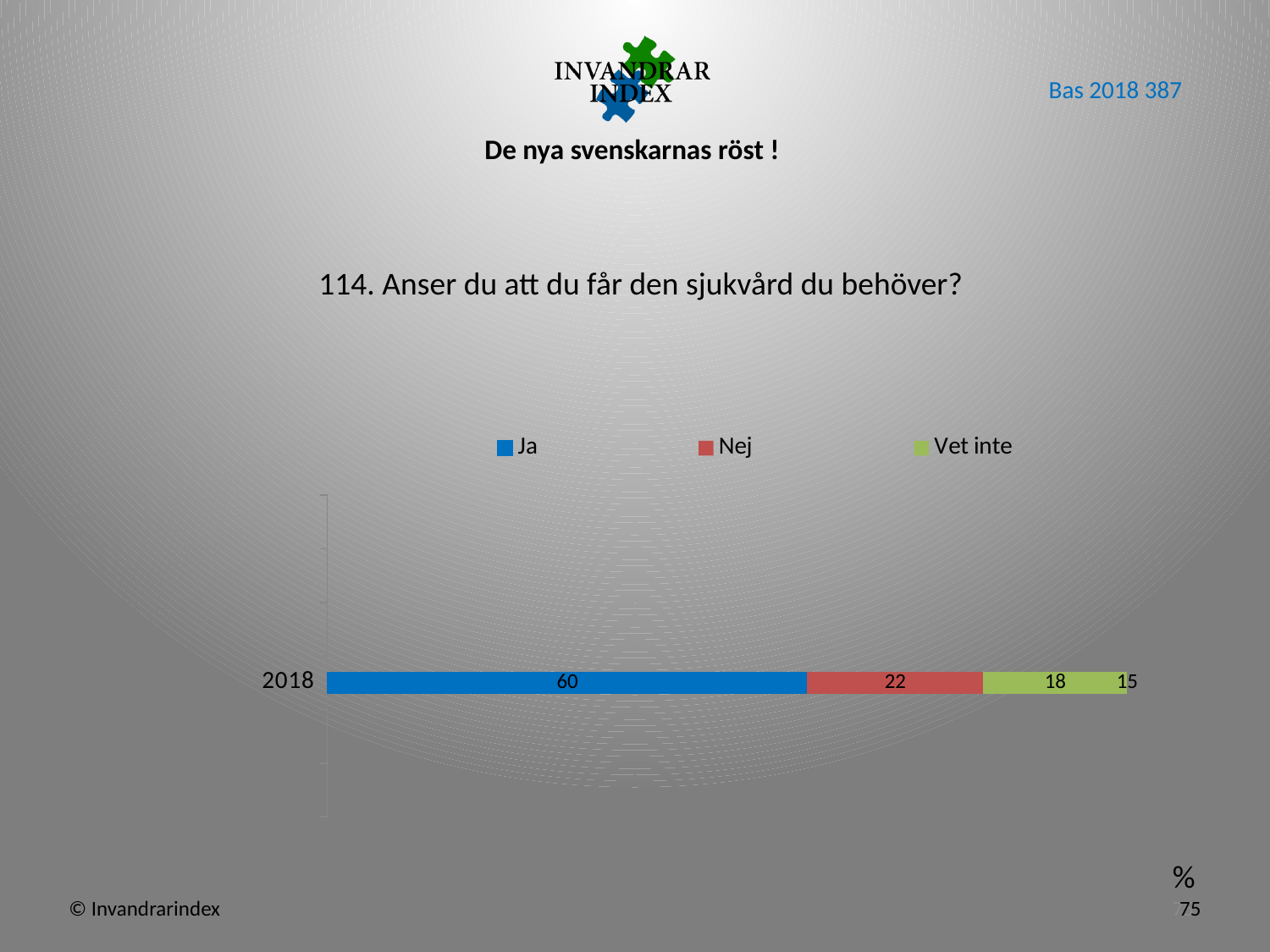
Which is larger in 2018, Ja or Nej? Ja Which series has the highest value in 2018? Ja What kind of chart is shown on the slide? Stacked bar chart What is the value for Nej in 2018? 22 What is the difference between the Nej and Vet inte values in 2018? 4 Which of the legend series has the lowest value in 2018? Vet inte How many series does the legend list? 3 What colour is the Nej series in the chart? Red Which year is shown as the category on the chart? 2018 What is the value for Ja in 2018? 60 What is the value for Vet inte in 2018? 18 What is the difference between the Ja and Nej values in 2018? 38